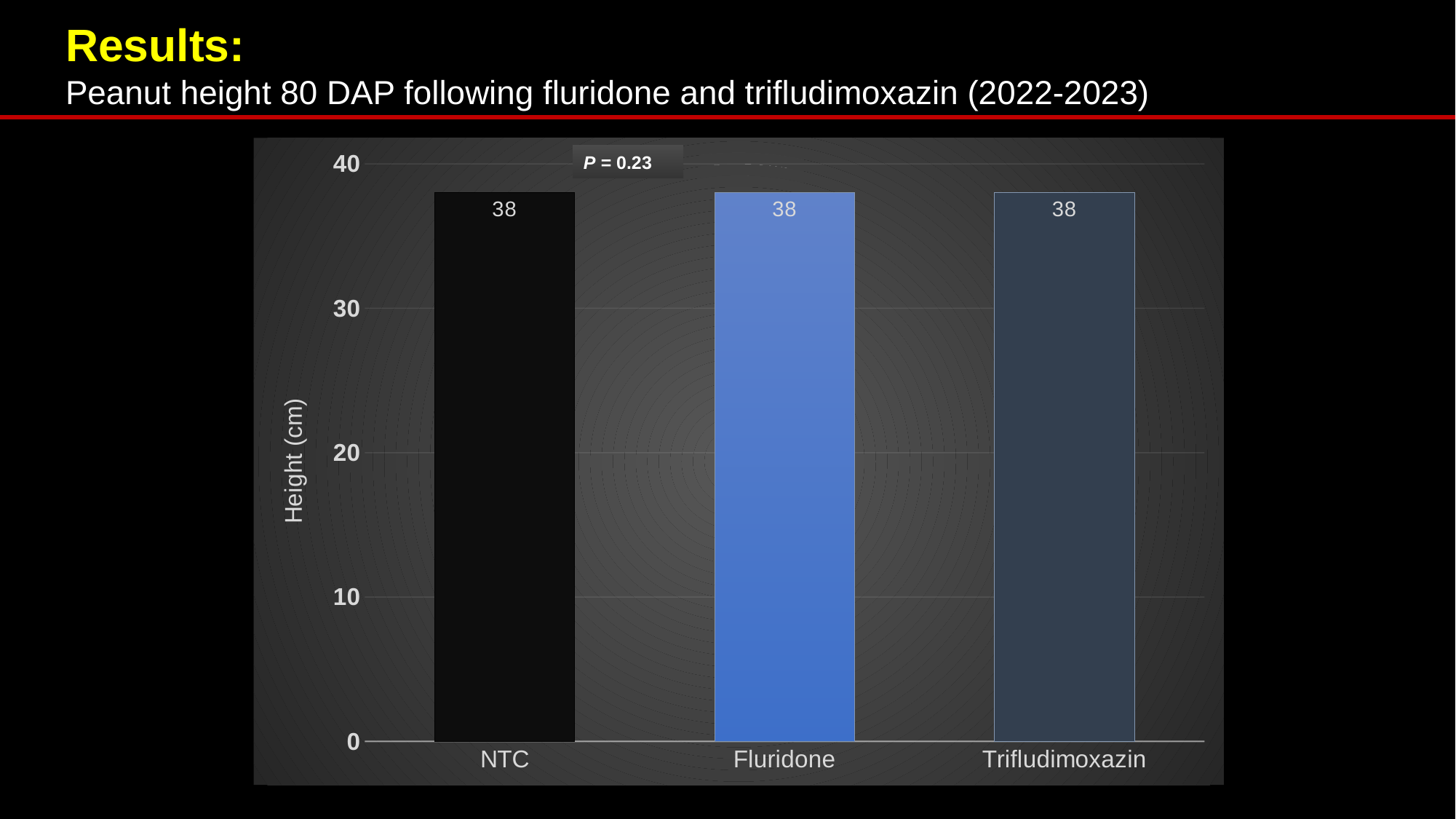
Is the value for NTC greater or less than 40? less What P value is shown on the chart? P = 0.23 What is the height value for Fluridone? 38 What is the height value for Trifludimoxazin? 38 Is the value for Trifludimoxazin greater or less than 30? greater What kind of chart is shown on the slide? bar chart How many treatment categories are shown on the x axis? 3 What is the label of the y axis? Height (cm) Do the values rise, fall, or stay the same across the categories from NTC to Trifludimoxazin? stay the same What is the difference between the height values for Fluridone and NTC? 0 What is the height value for NTC? 38